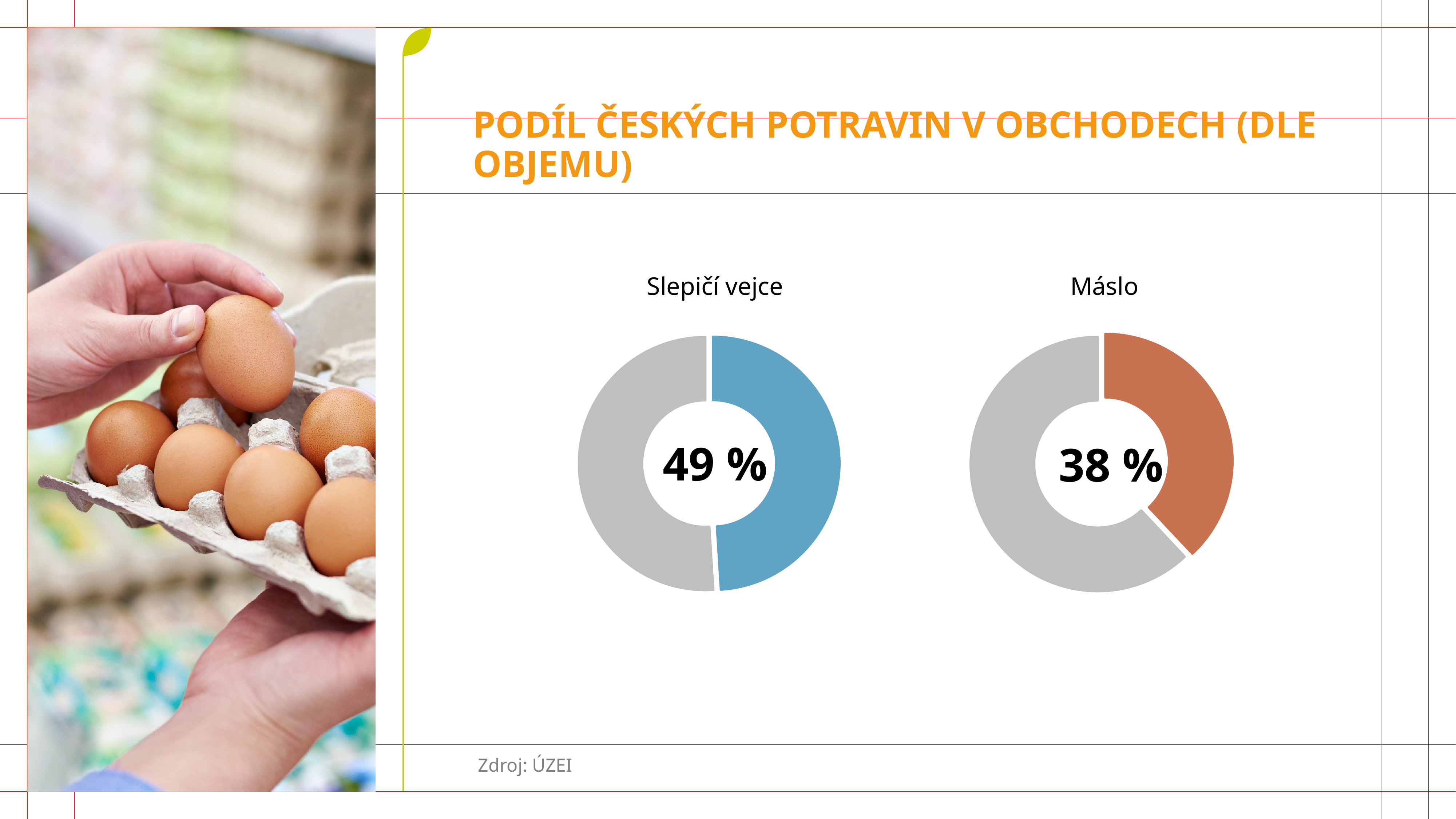
Which of the two charts shows the lowest share? Máslo Which chart shows the higher share of Czech food, 'Slepičí vejce' or 'Máslo'? Slepičí vejce What is the title of the slide above the charts? PODÍL ČESKÝCH POTRAVIN V OBCHODECH (DLE OBJEMU) What kind of chart is used for 'Slepičí vejce'? Doughnut chart In the 'Slepičí vejce' chart, is the coloured share greater or less than 50 %? less What is the difference between the share shown in the 'Slepičí vejce' chart and the share shown in the 'Máslo' chart? 11 % How many doughnut charts are on the slide? 2 In the 'Máslo' chart, what share is shown in the centre of the doughnut? 38 % In the 'Máslo' chart, is the coloured share greater or less than 40 %? less What colour is the highlighted segment in the 'Máslo' chart? Brown/orange In the 'Slepičí vejce' chart, what share is shown in the centre of the doughnut? 49 %